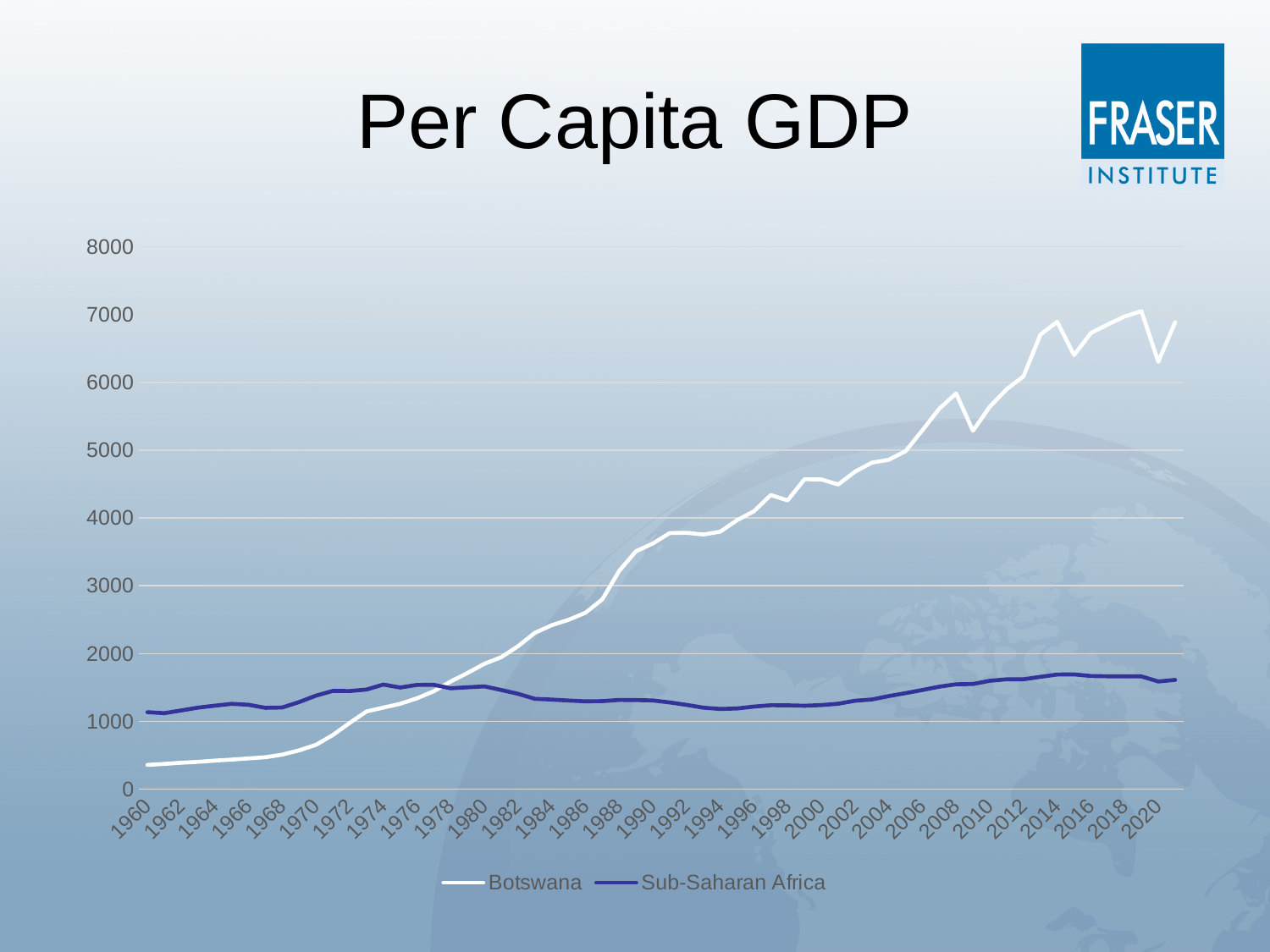
Does the Botswana line generally rise or fall from 1960 to 2020? rise Is the value for Botswana in 2000 greater or less than 4000? greater Is the value for Botswana in 2020 greater or less than 6000? greater Is the value for Botswana in 1960 greater or less than 1000? less Which series is drawn with the white line? Botswana In 1960, which series has the higher value, Botswana or Sub-Saharan Africa? Sub-Saharan Africa What kind of chart is shown on the slide? line chart How many series does the legend list? 2 What is the title of the chart? Per Capita GDP In 2020, which series has the higher value, Botswana or Sub-Saharan Africa? Botswana